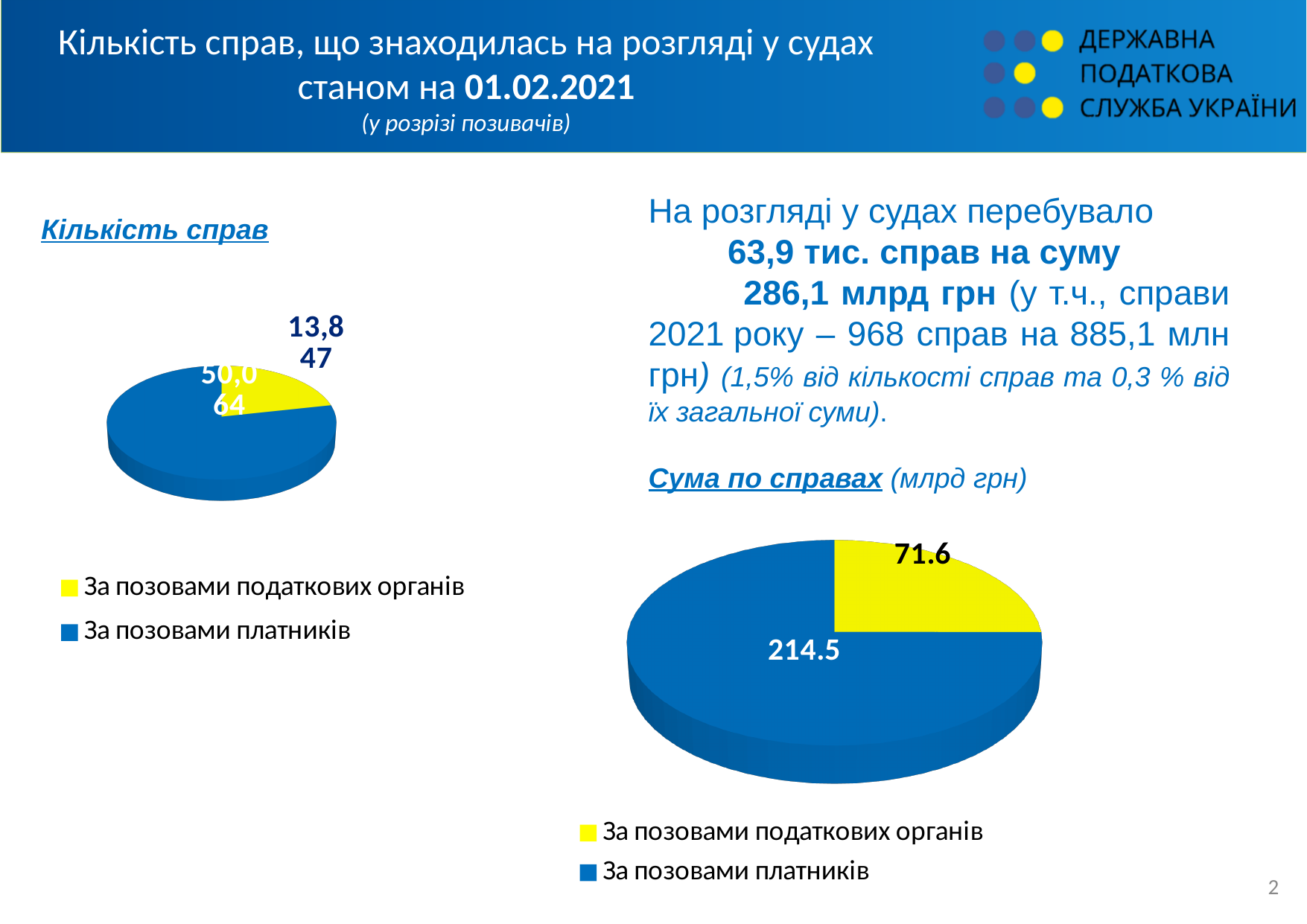
On the 'Кількість справ' chart, which slice is larger: 'За позовами податкових органів' or 'За позовами платників'? За позовами платників On the 'Сума по справах' chart, what is the total of the two slices? 286.1 On the 'Сума по справах' chart, which category has the largest slice? За позовами платників On the 'Сума по справах' chart, what is the difference between the values for 'За позовами платників' and 'За позовами податкових органів'? 142.9 On the 'Сума по справах' chart, what is the value for 'За позовами податкових органів'? 71.6 On the 'Сума по справах' chart, which category has the smallest slice? За позовами податкових органів On the 'Сума по справах' chart, what is the value for 'За позовами платників'? 214.5 What type of chart is the 'Кількість справ' chart? Pie chart How many categories does the legend of the 'Сума по справах' chart list? 2 What unit is given in the title of the 'Сума по справах' chart? млрд грн On the 'Сума по справах' chart, what colour is the slice for 'За позовами податкових органів'? Yellow